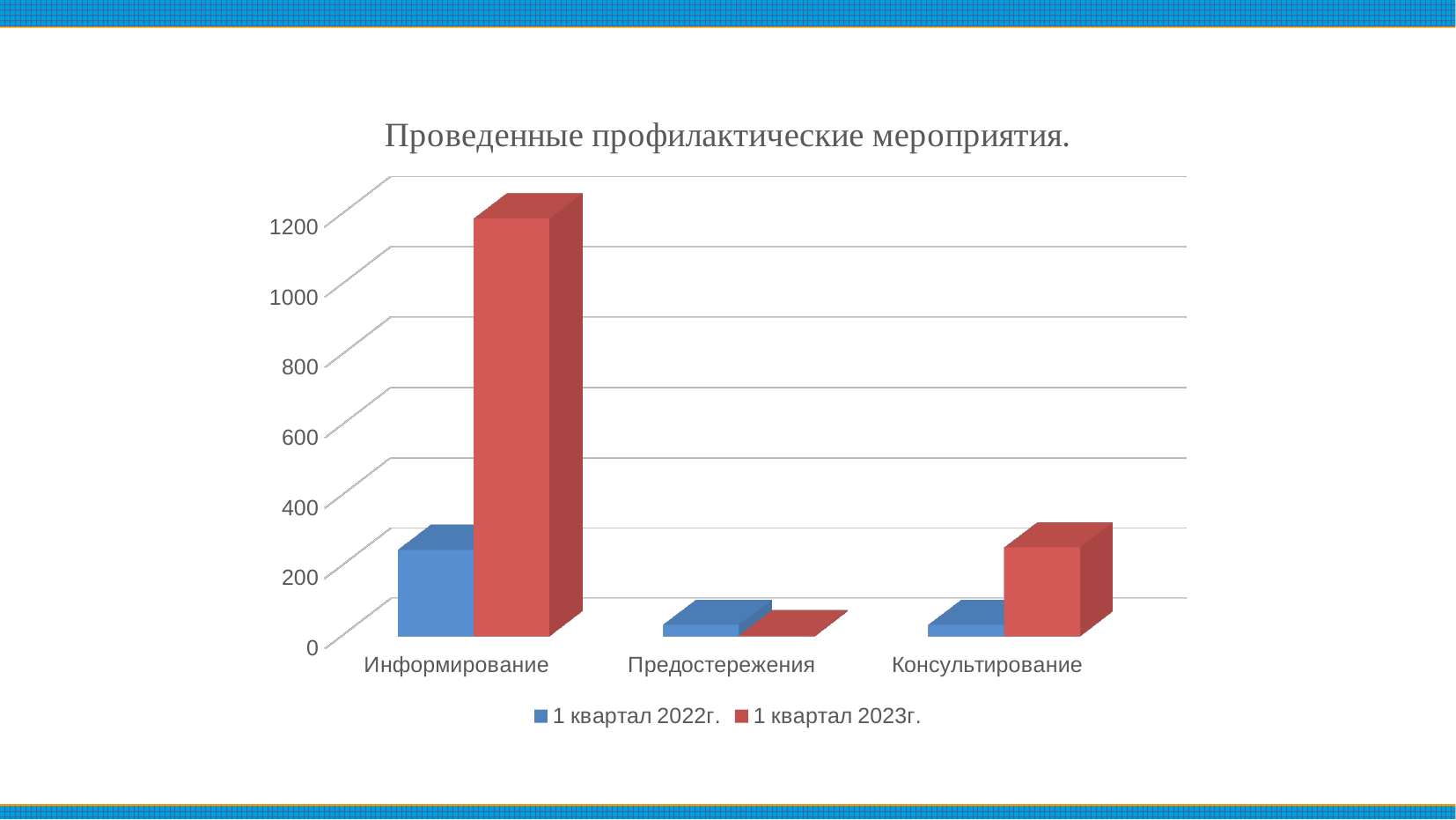
What are the two series named in the legend? 1 квартал 2022г. and 1 квартал 2023г. For Консультирование, which series has the larger value: 1 квартал 2022г. or 1 квартал 2023г.? 1 квартал 2023г. Which category has the highest value for the series 1 квартал 2023г.? Информирование Which category has the lowest value for the series 1 квартал 2023г.? Предостережения What kind of chart is shown on the slide? bar chart For Информирование, which series has the larger value: 1 квартал 2022г. or 1 квартал 2023г.? 1 квартал 2023г. How many categories are shown on the x axis of the chart? 3 How many series does the chart's legend list? 2 Is the value for Информирование in 1 квартал 2023г. greater or less than 1000? greater What is the title of the chart? Проведенные профилактические мероприятия. Is the value for Информирование in 1 квартал 2022г. greater or less than 400? less Is the value for Консультирование in 1 квартал 2023г. greater or less than 400? less